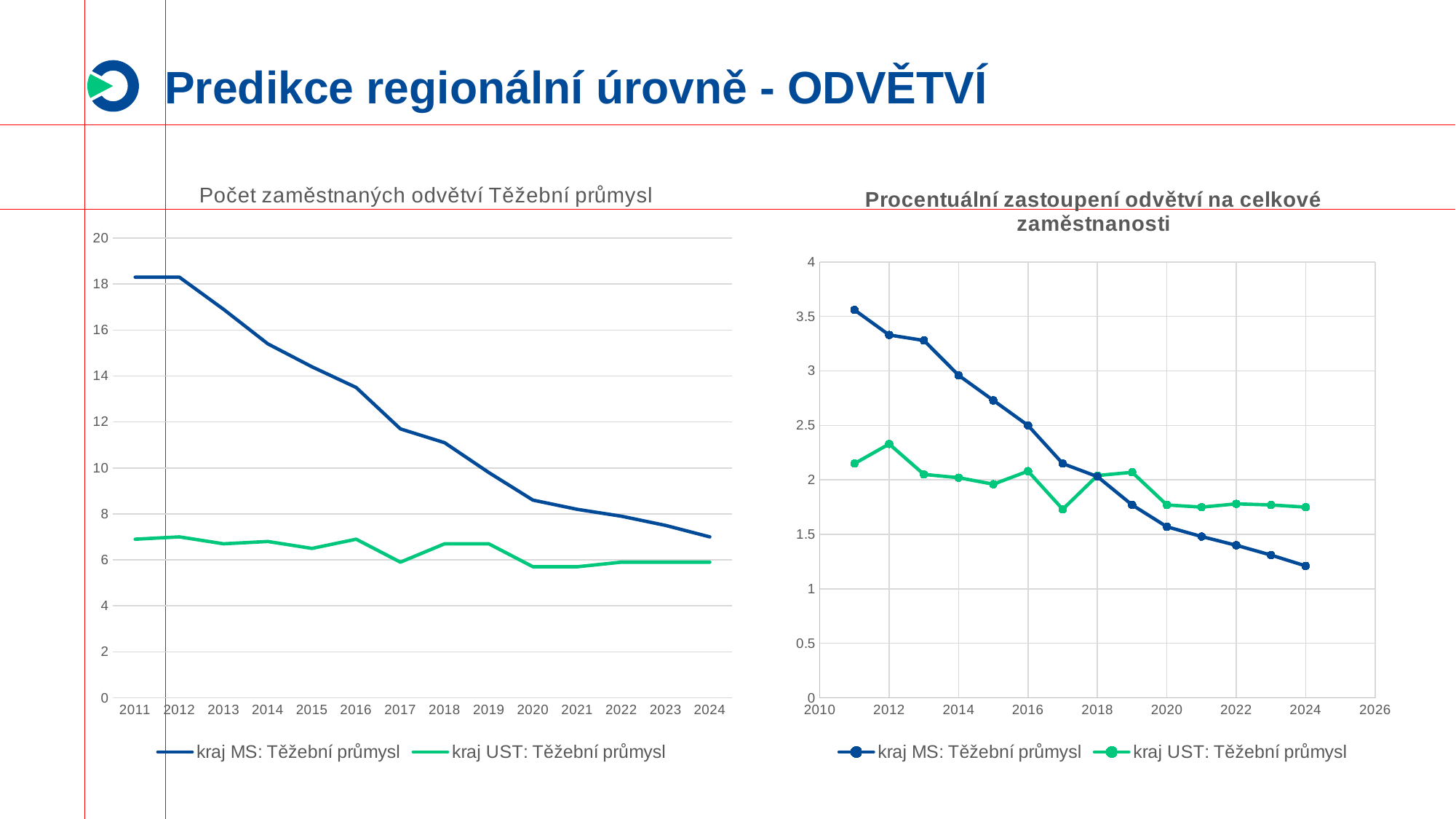
In the right chart "Procentuální zastoupení odvětví na celkové zaměstnanosti", in which year is the kraj UST: Těžební průmysl value highest? 2012 In the right chart "Procentuální zastoupení odvětví na celkové zaměstnanosti", in which year is the kraj MS: Těžební průmysl value lowest? 2024 In the right chart "Procentuální zastoupení odvětví na celkové zaměstnanosti", is the value for kraj MS: Těžební průmysl in 2011 greater or less than 3.5? greater How many series does the legend of the right chart "Procentuální zastoupení odvětví na celkové zaměstnanosti" list? 2 In the left chart "Počet zaměstnaných odvětví Těžební průmysl", is the value for kraj MS: Těžební průmysl in 2011 greater or less than 18? greater In the left chart "Počet zaměstnaných odvětví Těžební průmysl", how many years are shown on the x axis? 14 In the left chart "Počet zaměstnaných odvětví Těžební průmysl", which series has the higher value in 2016, kraj MS: Těžební průmysl or kraj UST: Těžební průmysl? kraj MS: Těžební průmysl What is the title of the right chart on the slide? Procentuální zastoupení odvětví na celkové zaměstnanosti What kind of chart is the left chart titled "Počet zaměstnaných odvětví Těžební průmysl"? line chart In the left chart "Počet zaměstnaných odvětví Těžební průmysl", does the kraj MS: Těžební průmysl line rise or fall from 2011 to 2024? fall In the right chart "Procentuální zastoupení odvětví na celkové zaměstnanosti", which series has the higher value in 2024, kraj MS: Těžební průmysl or kraj UST: Těžební průmysl? kraj UST: Těžební průmysl